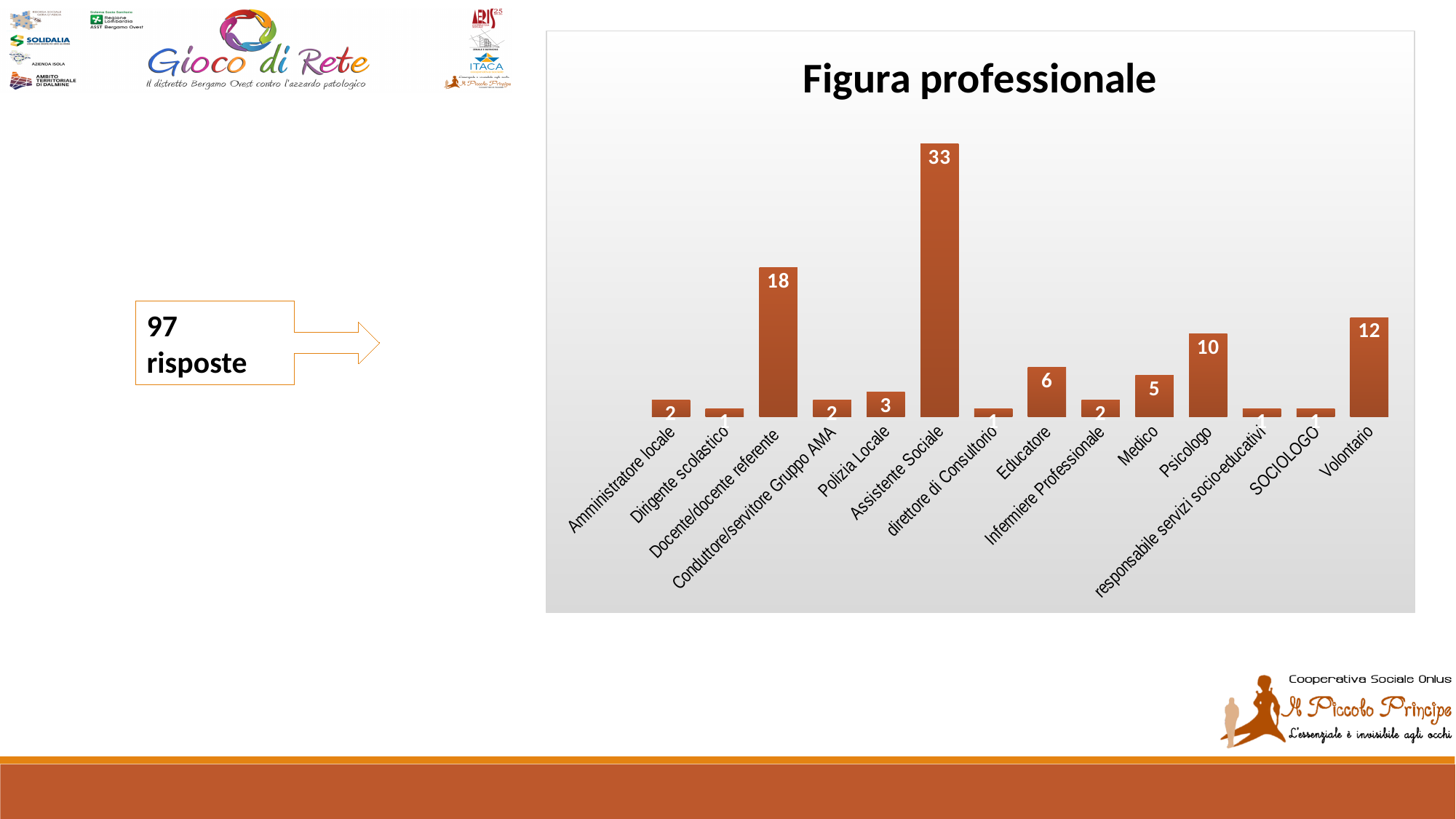
What is the difference between the values for Assistente Sociale and Docente/docente referente? 15 What is the value for Medico? 5 What kind of chart is shown on the slide? Bar chart Which is larger, the value for Educatore or the value for Medico? Educatore What is the value for Assistente Sociale? 33 Which category has the highest value? Assistente Sociale What is the value for Docente/docente referente? 18 How many categories are shown in the chart? 14 What is the value for Psicologo? 10 What is the difference between the values for Volontario and Psicologo? 2 What is the title of the chart? Figura professionale What is the value for Volontario? 12